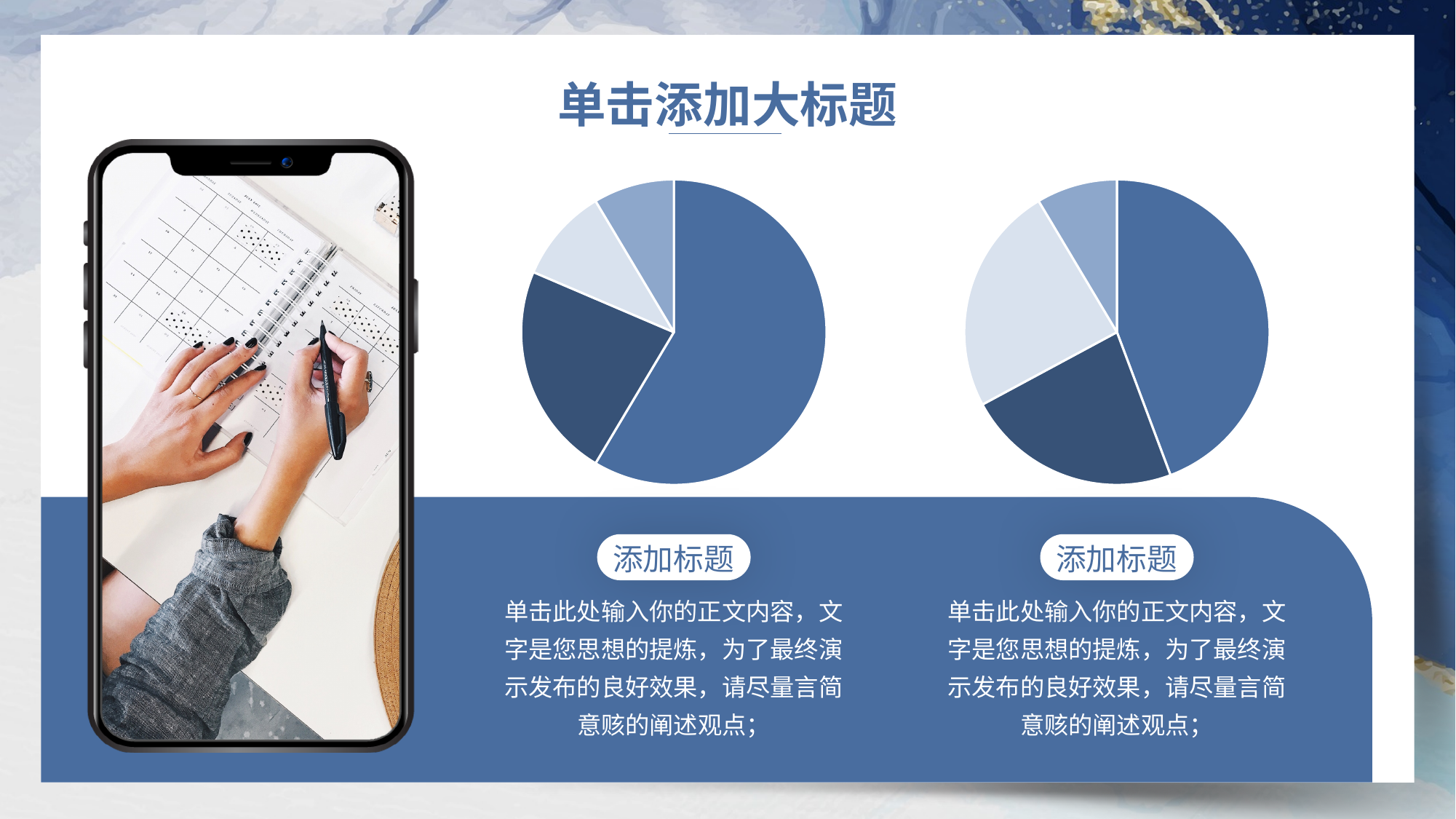
How many pie charts are on the slide? 2 What kind of chart is the pie chart on the left side of the slide? Pie chart In the left pie chart, which slice is the largest? The medium blue slice on the right In the left pie chart, which is larger: the dark navy slice or the pale grey-blue slice? The dark navy slice Does either pie chart on the slide show a legend? No In the right pie chart, which slice is the largest? The medium blue slice on the right What kind of chart is the pie chart on the right side of the slide? Pie chart In the left pie chart, which slice is the smallest? The small light blue slice at the top In the right pie chart, which slice is the smallest? The small light blue slice at the top In the right pie chart, how many slices are there? 4 In the left pie chart, how many slices are there? 4